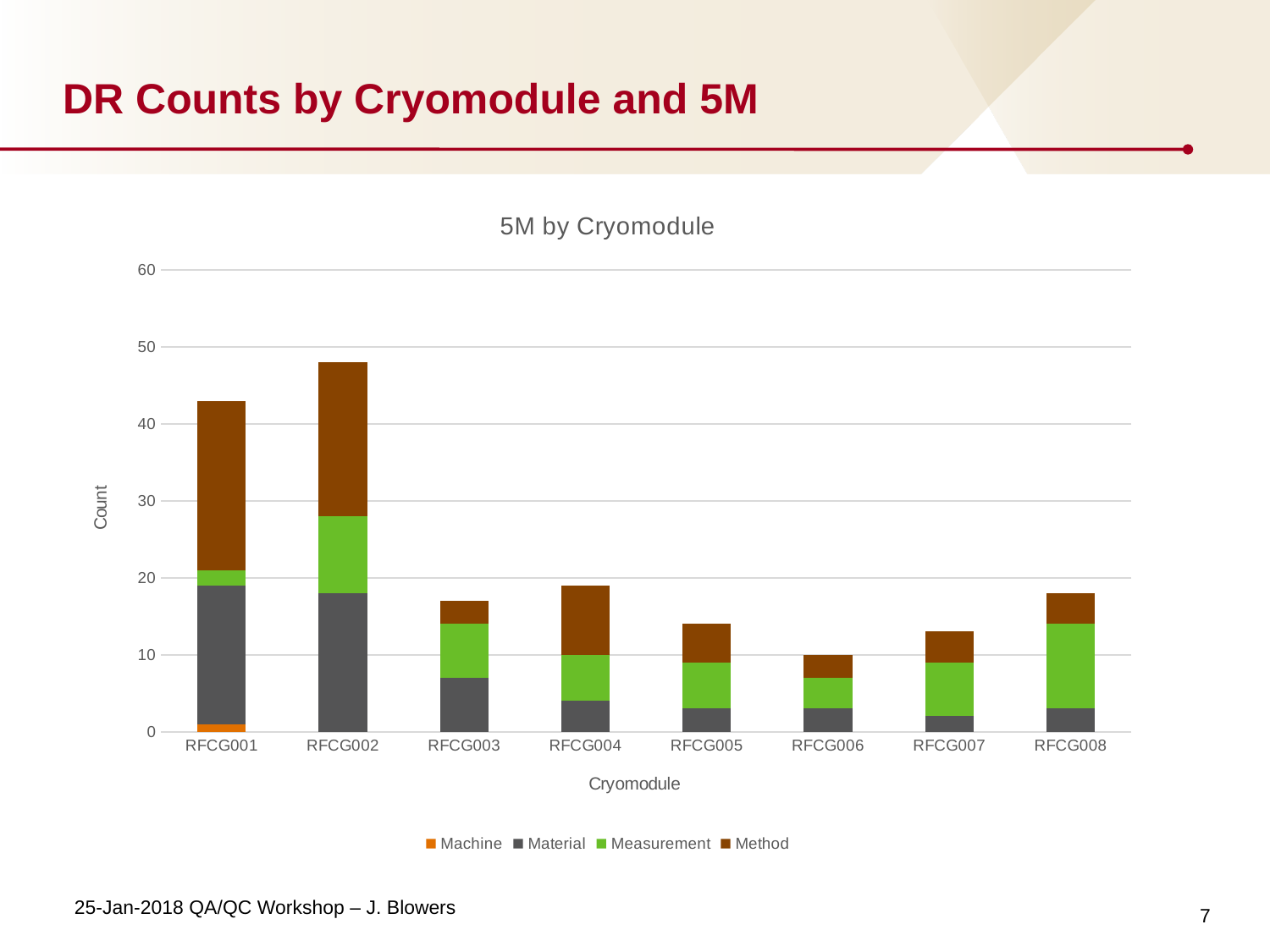
How many cryomodules are shown on the x axis of the chart? 8 What type of chart is shown on the slide? Stacked bar chart Which cryomodule has the lowest total count? RFCG006 How many series does the chart legend list? 4 Which has a larger total count, RFCG003 or RFCG006? RFCG003 Which cryomodule has the highest total count? RFCG002 Which has a larger total count, RFCG001 or RFCG002? RFCG002 Is the total count for RFCG003 greater or less than 20? less Is the total count for RFCG002 greater or less than 50? less Is the total count for RFCG001 greater or less than 40? greater What is the title of the chart? 5M by Cryomodule Which cryomodule is the only one with a Machine segment in its bar? RFCG001